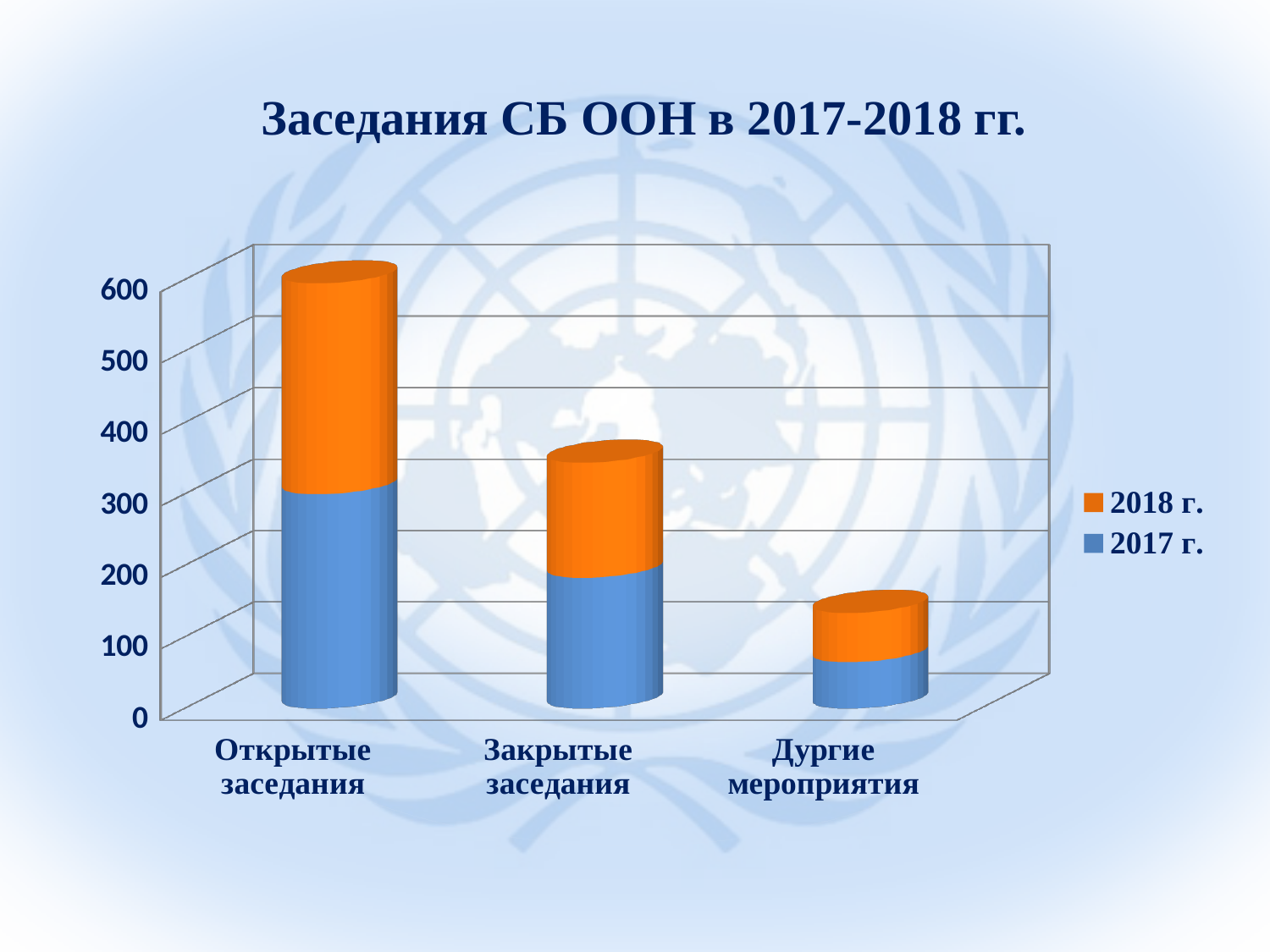
How many categories are shown on the x axis of the chart? 3 Do the total bar heights rise or fall from left to right across the categories? fall Is the total value for Закрытые заседания greater or less than 200? greater What is the title of the chart? Заседания СБ ООН в 2017-2018 гг. Which colour represents the 2017 г. series in the legend? Blue Is the total value for Дургие мероприятия greater or less than 200? less How many series does the legend list? 2 What kind of chart is shown on the slide? Stacked bar chart Which category has the highest total bar? Открытые заседания Which category has the lowest total bar? Дургие мероприятия Which has a larger total bar: Открытые заседания or Закрытые заседания? Открытые заседания Is the total value for Открытые заседания greater or less than 400? greater